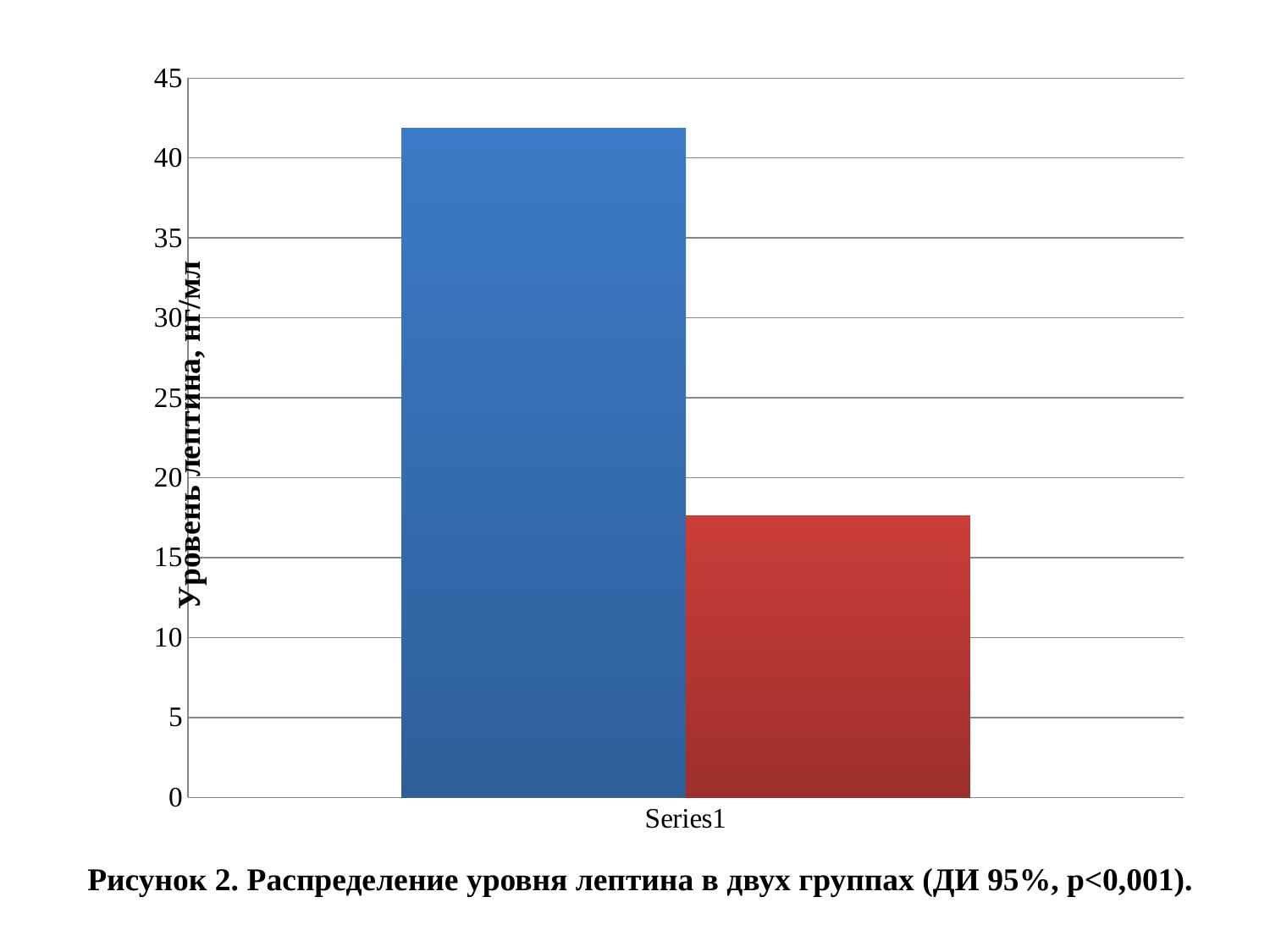
Which bar has the lowest value? the red bar What is the label on the vertical axis of the chart? Уровень лептина, нг/мл Is the value of the blue bar greater or less than 45? less Is the value of the red bar greater or less than 20? less Which bar is taller, the blue bar or the red bar? the blue bar What is the maximum value shown on the vertical axis? 45 Is the value of the blue bar greater or less than 40? greater How many bars are plotted in the chart? 2 What kind of chart is shown on the slide? bar chart What is the category label shown on the horizontal axis? Series1